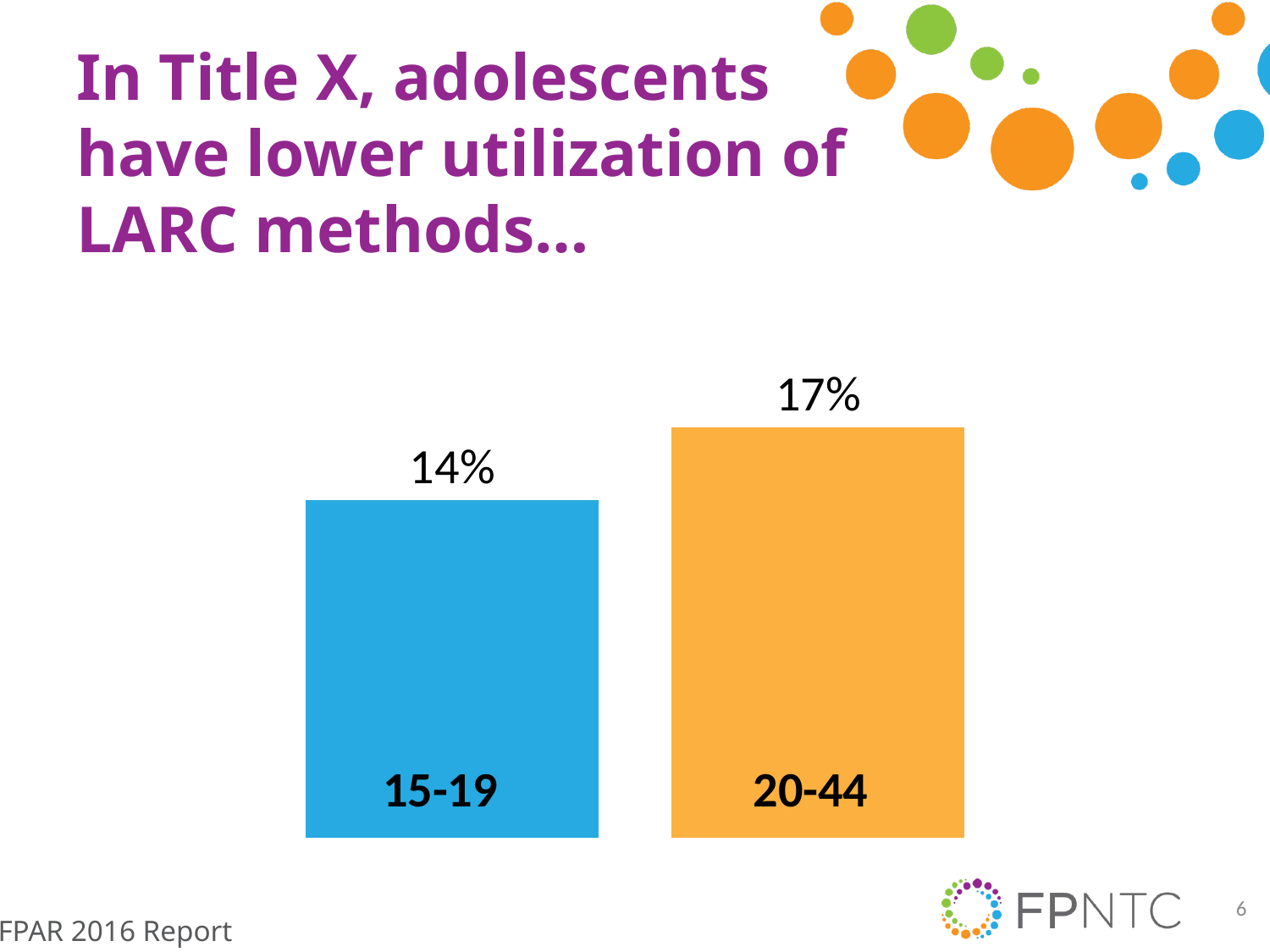
What is the value for the 20-44 age group? 17% What is the difference between the values for 20-44 and 15-19? 3% Which age group has the lowest value? 15-19 Which is larger, the value for 15-19 or the value for 20-44? 20-44 How many age groups are shown in the chart? 2 What colour is the bar for the 20-44 age group? orange What kind of chart is shown on the slide? bar chart What is the value for the 15-19 age group? 14% What colour is the bar for the 15-19 age group? blue Do the values rise or fall from the 15-19 bar to the 20-44 bar? rise Which age group has the highest value? 20-44